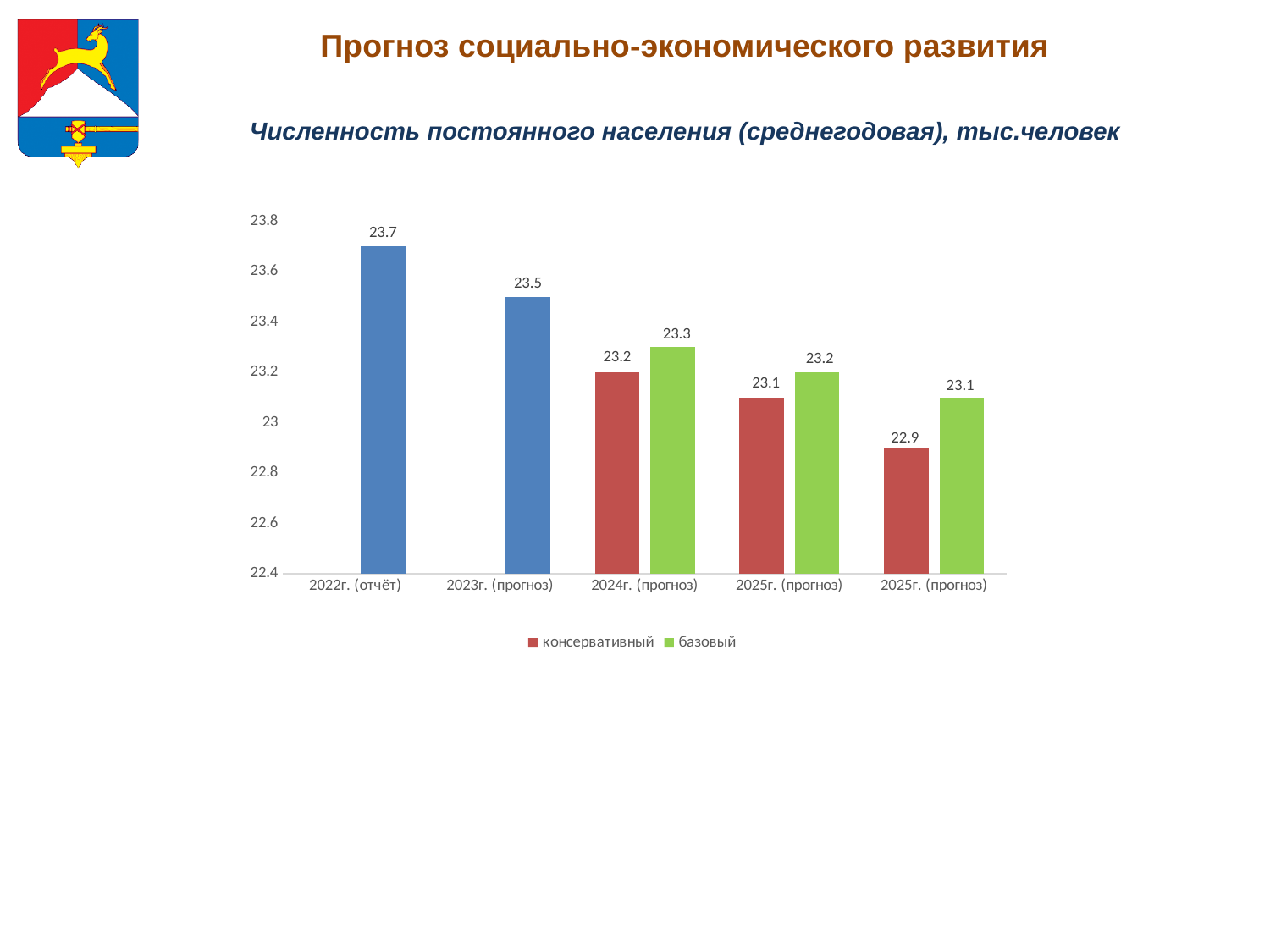
What is the value of the консервативный series for 2024г. (прогноз)? 23.2 What is the value of the консервативный series in the last (rightmost) category? 22.9 How many series does the legend list? 2 What is the difference between the values for 2022г. (отчёт) and 2023г. (прогноз)? 0.2 Which category has the highest value on the chart? 2022г. (отчёт) For 2024г. (прогноз), which series has the larger value, консервативный or базовый? базовый What is the value of the базовый series for 2024г. (прогноз)? 23.3 What is the value for 2023г. (прогноз)? 23.5 Do the values generally rise or fall from left to right along the x axis? fall What is the lowest value shown on the chart? 22.9 What kind of chart is shown on the slide? bar chart What is the value for 2022г. (отчёт)? 23.7